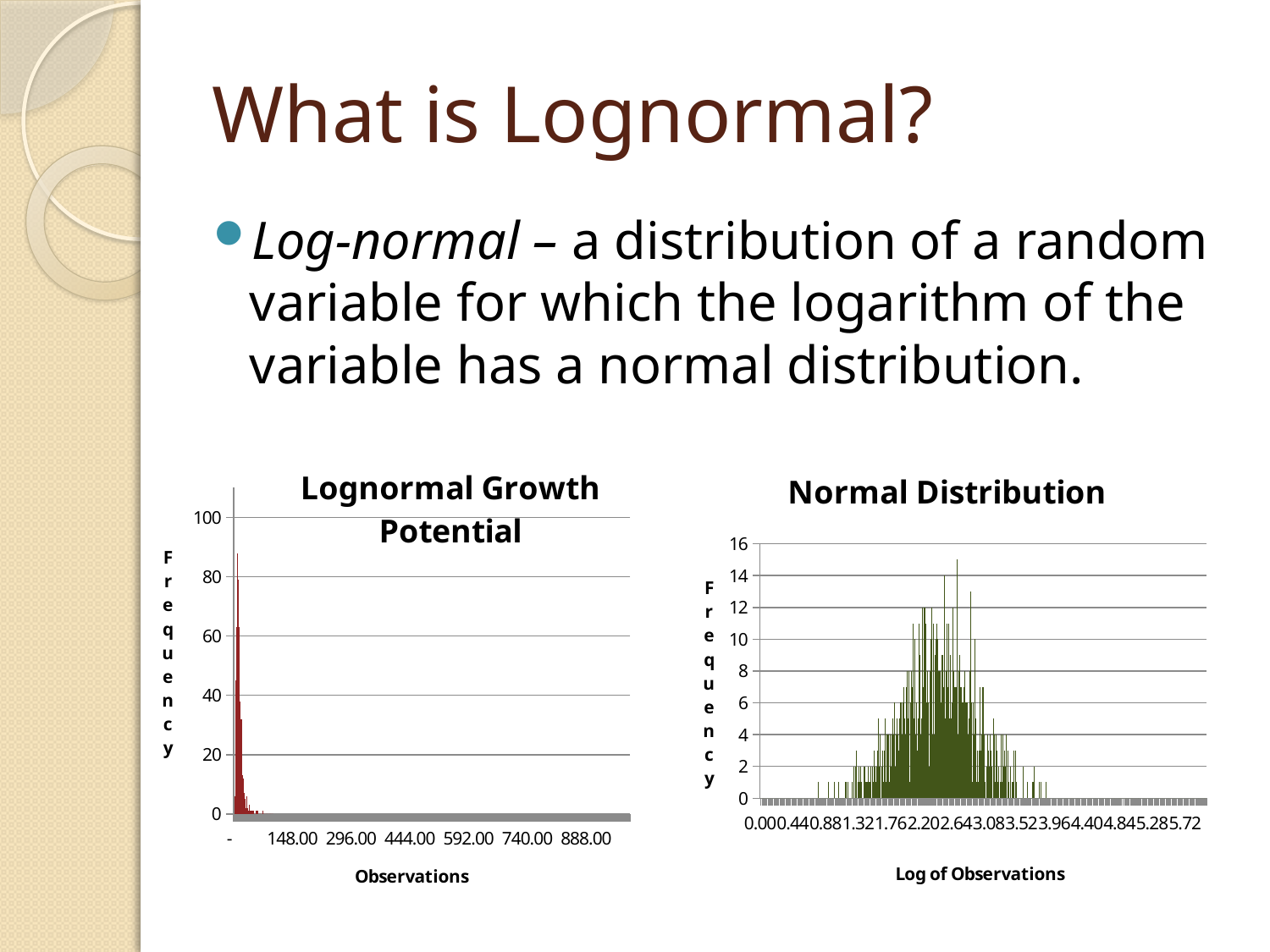
In the "Lognormal Growth Potential" chart, is the tallest bar greater or less than 100? less What kind of chart is the "Lognormal Growth Potential" chart? bar chart What is the highest value shown on the y axis of the "Lognormal Growth Potential" chart? 100 In the "Lognormal Growth Potential" chart, do the bar heights rise or fall as you move right along the x axis past the peak? fall What is the x-axis title of the "Normal Distribution" chart? Log of Observations In the "Lognormal Growth Potential" chart, is the tallest bar greater or less than 80? greater What kind of chart is the "Normal Distribution" chart? bar chart In the "Normal Distribution" chart, is the tallest bar greater or less than 12? greater What is the x-axis title of the "Lognormal Growth Potential" chart? Observations What is the highest value shown on the y axis of the "Normal Distribution" chart? 16